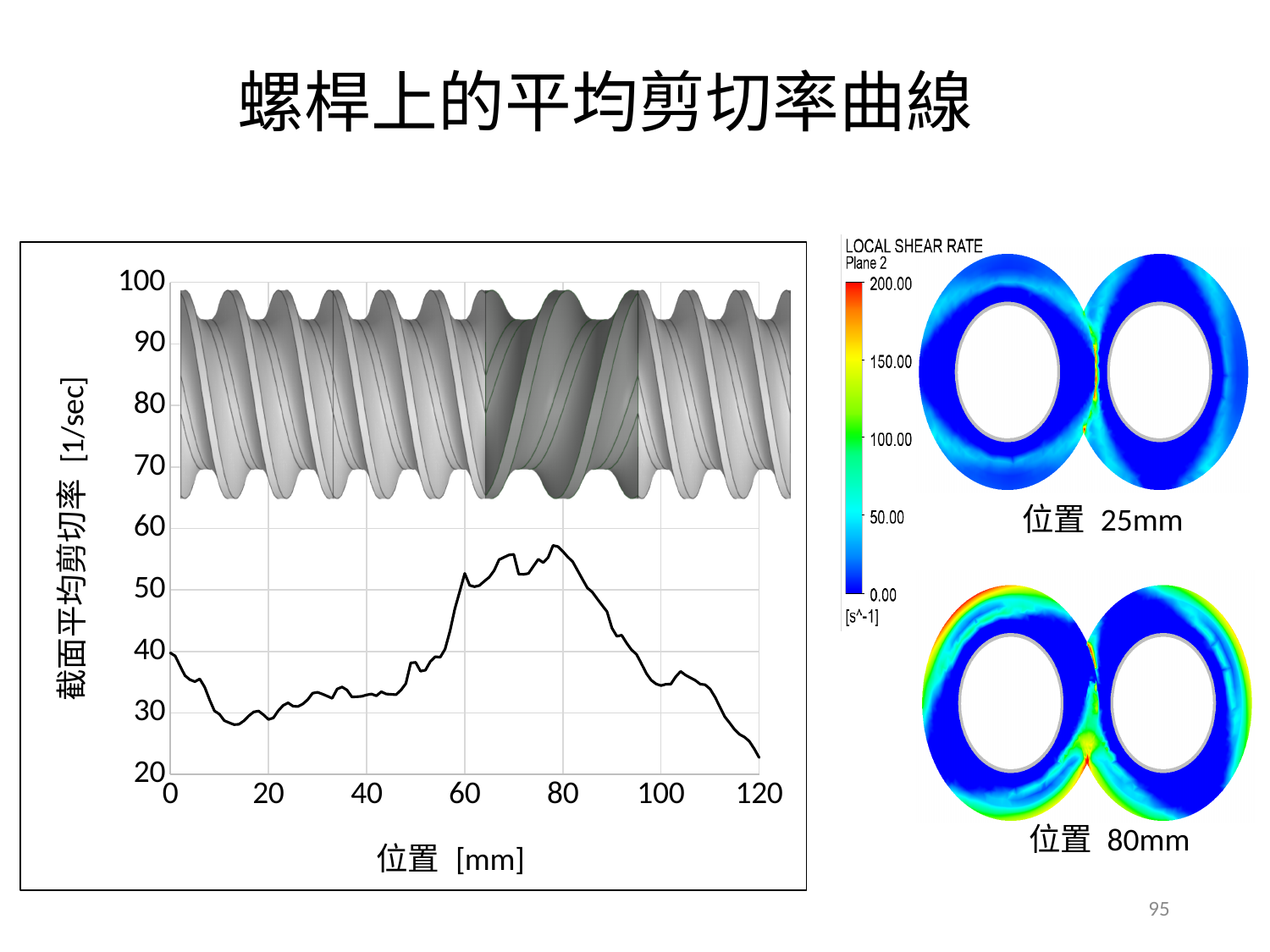
In the line chart, does the curve rise or fall between position 40 mm and position 60 mm? rise What is the label of the x axis of the line chart? 位置 [mm] What is the maximum value shown on the y axis of the line chart? 100 In the line chart, is the value at position 80 mm larger or smaller than the value at position 20 mm? larger In the line chart, is the value at position 100 mm greater or less than 50? less In the line chart, is the value at position 20 mm greater or less than 40? less In the line chart, is the value at position 120 mm greater or less than 30? less What kind of chart is the chart on the left of the slide? line chart In the line chart, does the curve rise or fall between position 80 mm and position 120 mm? fall